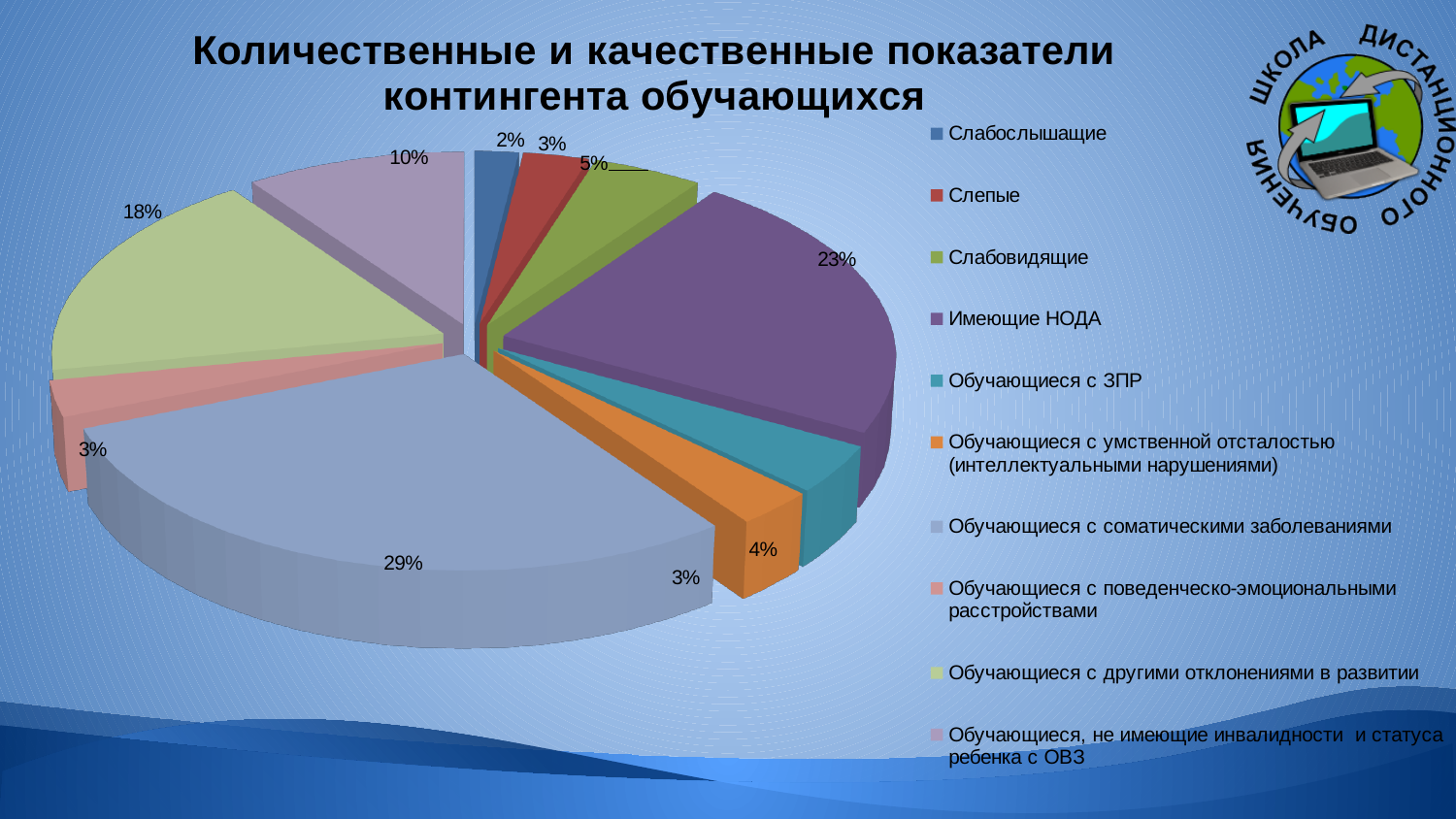
What is the title of the chart on the slide? Количественные и качественные показатели контингента обучающихся What percentage of the pie chart is labelled for Слабослышащие? 2% Which category has the largest share of the pie? Обучающиеся с соматическими заболеваниями Which is larger: the share for Слабовидящие or the share for Обучающиеся с умственной отсталостью (интеллектуальными нарушениями)? Слабовидящие Which category has the smallest share of the pie? Слабослышащие What percentage is shown for Обучающиеся с соматическими заболеваниями? 29% What type of chart is shown on the slide? pie chart What percentage is shown for Обучающиеся, не имеющие инвалидности и статуса ребенка с ОВЗ? 10% What percentage is shown for Имеющие НОДА? 23% What is the difference in percentage points between Обучающиеся с соматическими заболеваниями and Имеющие НОДА? 6 What percentage is shown for Обучающиеся с другими отклонениями в развитии? 18% How many categories does the legend list? 10